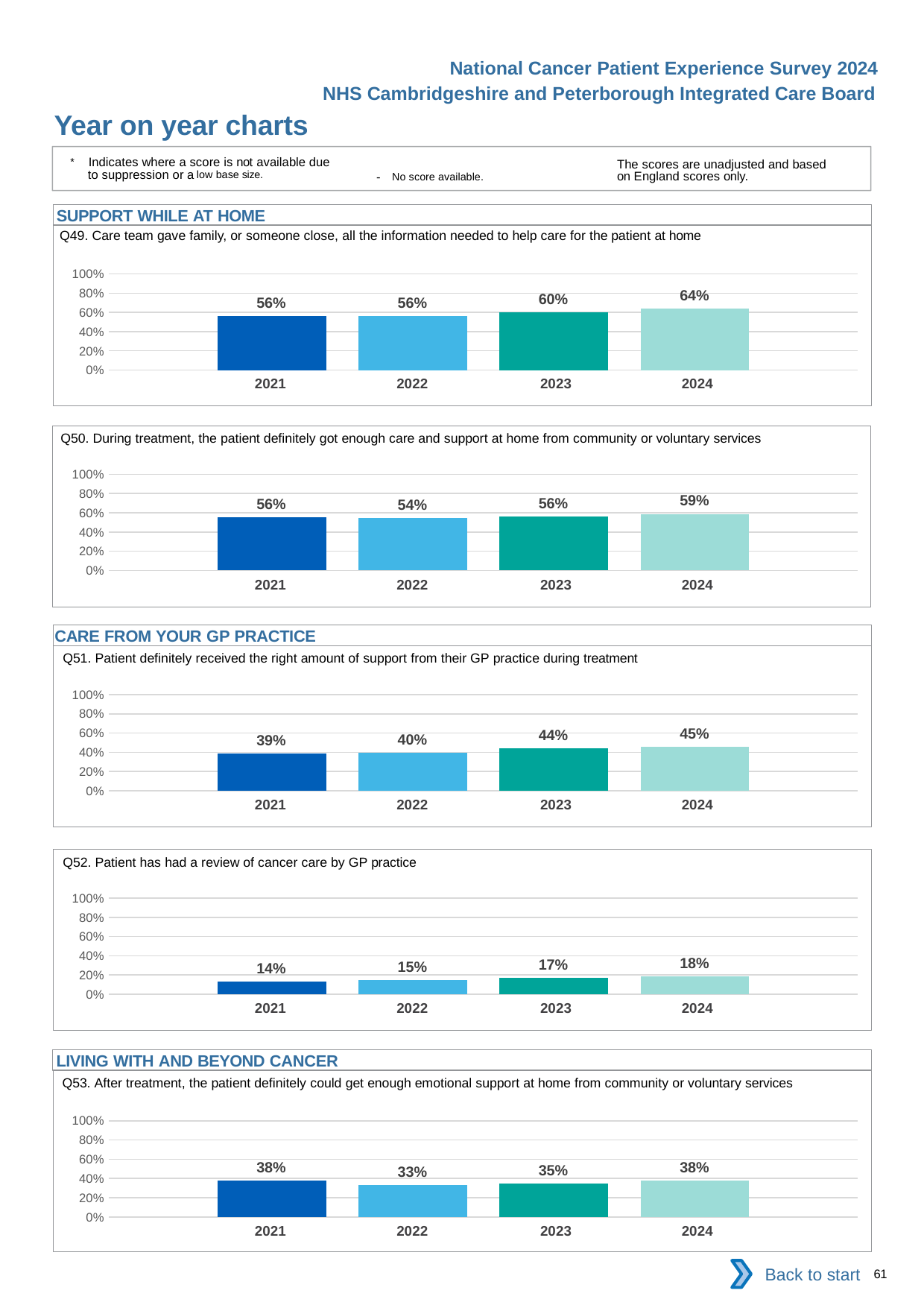
In the Q52 chart, is the value for 2021 greater or less than 20%? less Which section heading appears above the Q53 chart? LIVING WITH AND BEYOND CANCER In the Q49 chart, what is the value for 2024? 64% In the Q49 chart, is the value for 2023 larger or smaller than the value for 2022? larger In the Q52 chart, which year has the highest value? 2024 How many years are shown on the x axis of the Q50 chart? 4 In the Q53 chart, what is the value for 2022? 33% What kind of chart is the Q51 chart? bar chart In the Q50 chart, what is the value for 2024? 59% In the Q51 chart, do the values rise or fall from 2021 to 2024? rise In the Q51 chart, what is the difference between the 2024 and 2021 values? 6% In the Q50 chart, which year has the lowest value? 2022